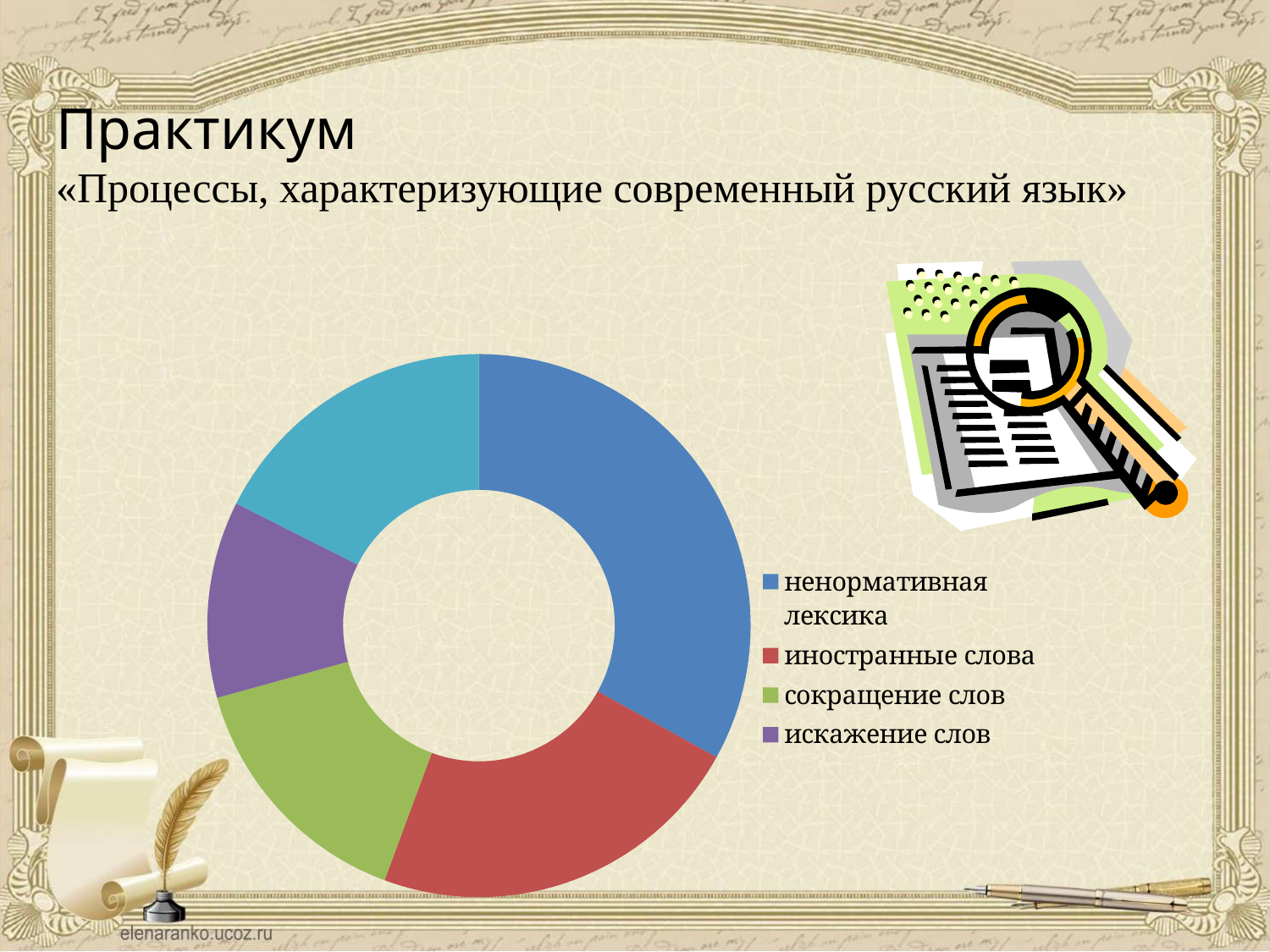
Which slice is larger: ненормативная лексика or иностранные слова? ненормативная лексика Which legend entry is shown in green? сокращение слов How many slices does the doughnut chart have? 5 What colour represents иностранные слова in the chart? Red How many entries does the chart legend list? 4 Which slice is larger: ненормативная лексика or сокращение слов? ненормативная лексика Which slice is larger: иностранные слова or искажение слов? иностранные слова What kind of chart is shown on the slide? Doughnut chart Which category has the largest slice in the doughnut chart? ненормативная лексика